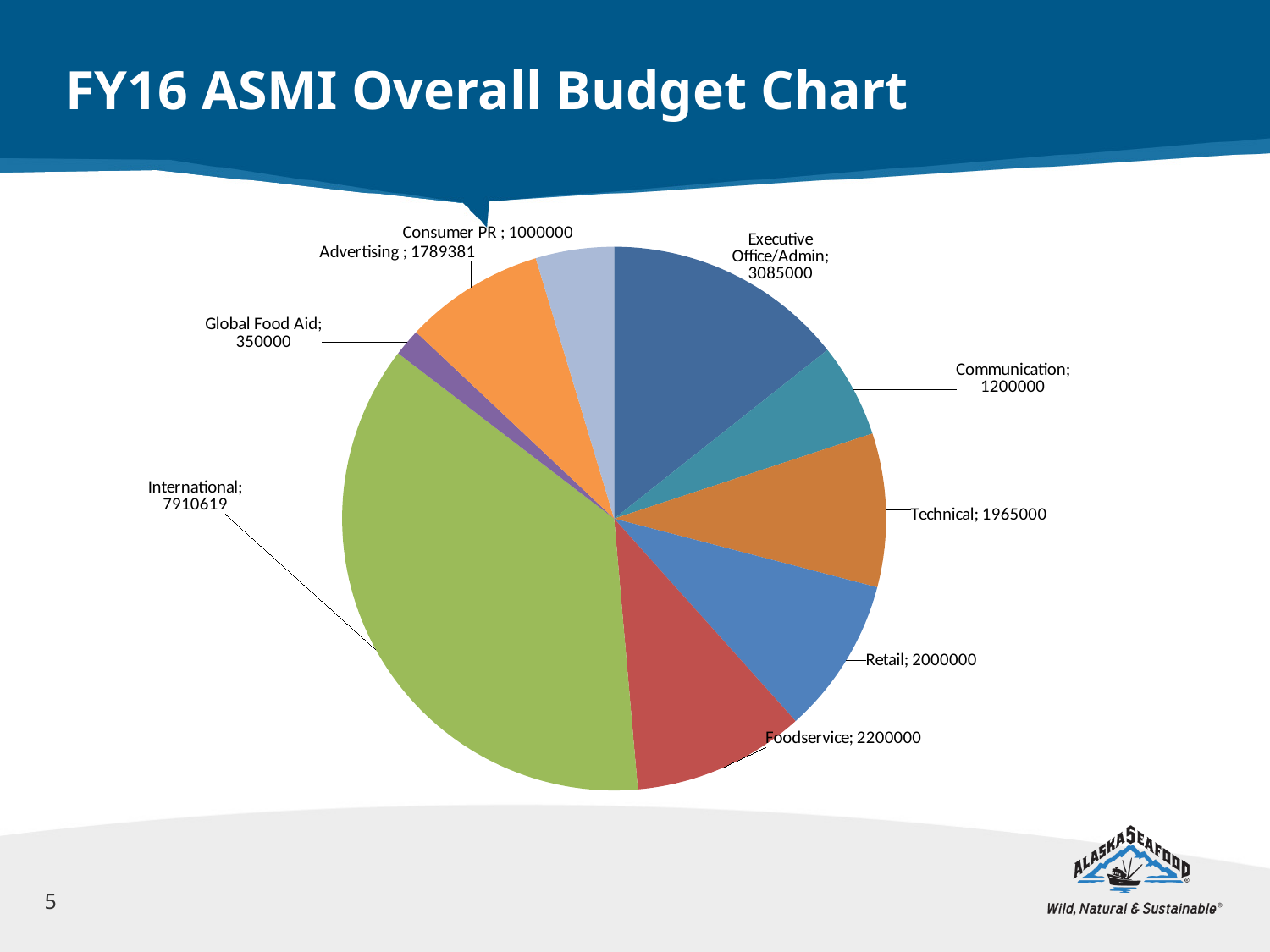
Which category has the largest budget? International What is the budget value for Advertising? 1789381 What is the title of the slide containing the chart? FY16 ASMI Overall Budget Chart Which category has the smallest budget? Global Food Aid What is the budget value for Global Food Aid? 350000 How many categories are shown in the pie chart? 9 What is the difference between the Foodservice and Retail budgets? 200000 What kind of chart is shown on the slide? Pie chart What is the budget value for International? 7910619 What is the budget value for Executive Office/Admin? 3085000 Which is larger, the Retail budget or the Technical budget? Retail What is the difference between the International and Executive Office/Admin budgets? 4825619